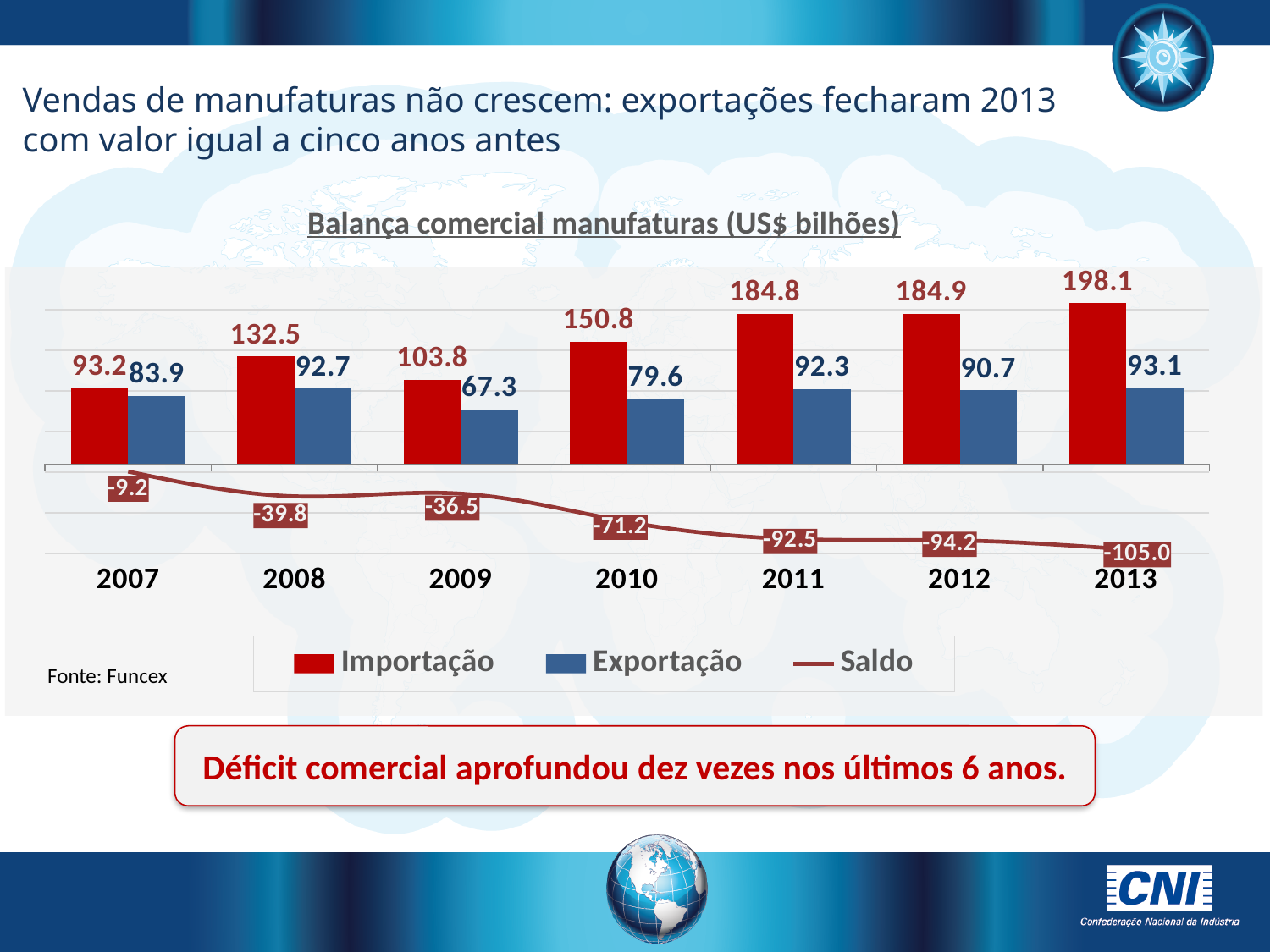
Which is larger, Importação in 2009 or Importação in 2010? Importação in 2010 By how much did Importação increase from 2007 to 2008? 39.3 How many years are shown on the x axis? 7 In which year is Importação highest? 2013 What is the Importação value for 2013? 198.1 How many series does the legend list? 3 What is the Exportação value for 2009? 67.3 Does the Saldo line rise or fall from 2007 to 2013? Fall What is the Saldo value for 2010? -71.2 In which year is Exportação lowest? 2009 What is the difference between Importação and Exportação in 2013? 105.0 What kind of chart is this? Bar chart with a line